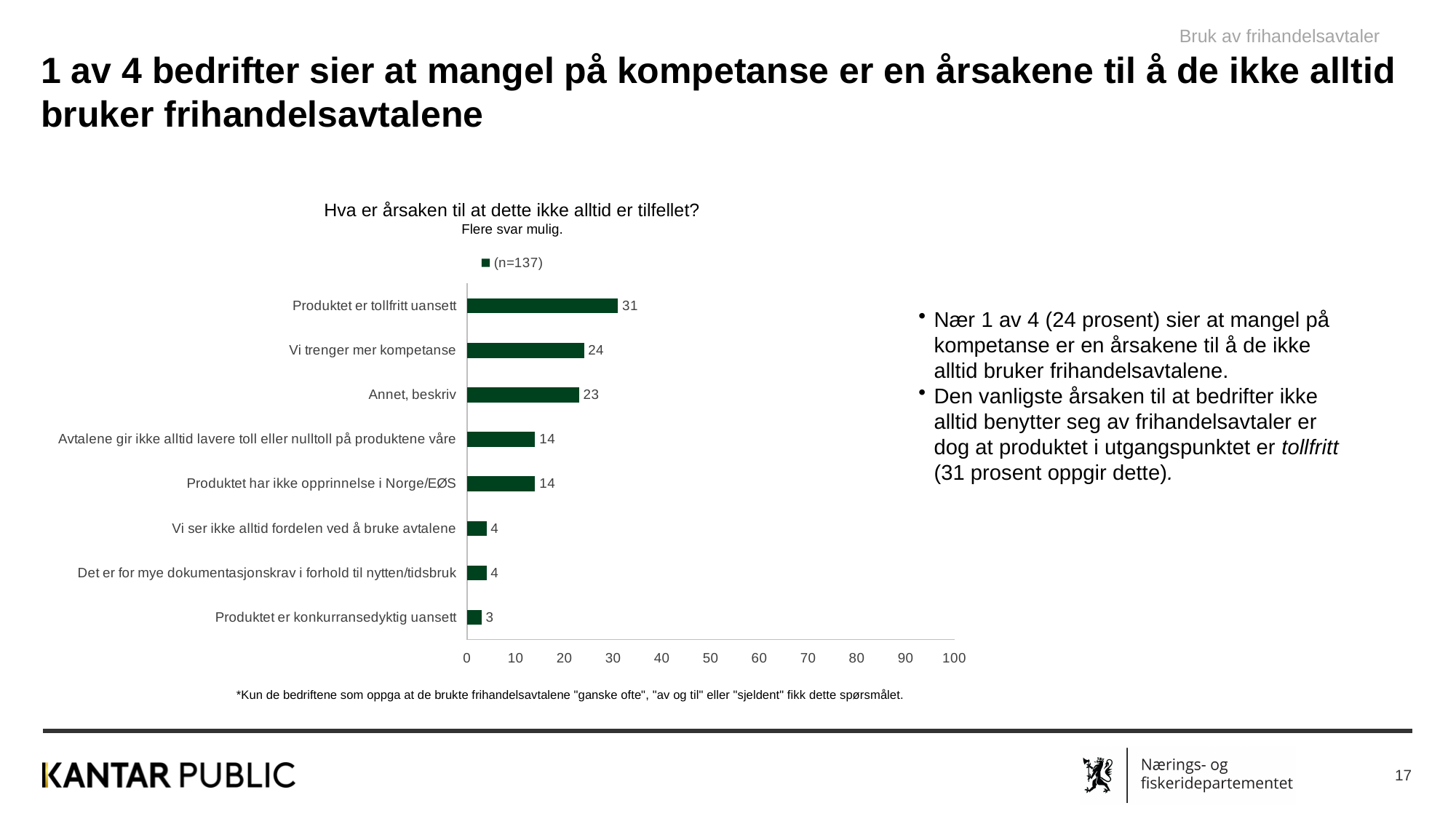
What is the value for "Vi trenger mer kompetanse"? 24 What is the legend entry of the chart? (n=137) What kind of chart is shown on the slide? bar chart What is the difference between the values for "Produktet er tollfritt uansett" and "Vi trenger mer kompetanse"? 7 Which is larger: the value for "Annet, beskriv" or the value for "Avtalene gir ikke alltid lavere toll eller nulltoll på produktene våre"? Annet, beskriv How many series does the legend list? 1 How many categories are shown in the chart? 8 Is the value for "Produktet er tollfritt uansett" greater or less than 30? greater Which category has the highest value? Produktet er tollfritt uansett Which category has the lowest value? Produktet er konkurransedyktig uansett What is the value for "Produktet er tollfritt uansett"? 31 What is the value for "Produktet har ikke opprinnelse i Norge/EØS"? 14